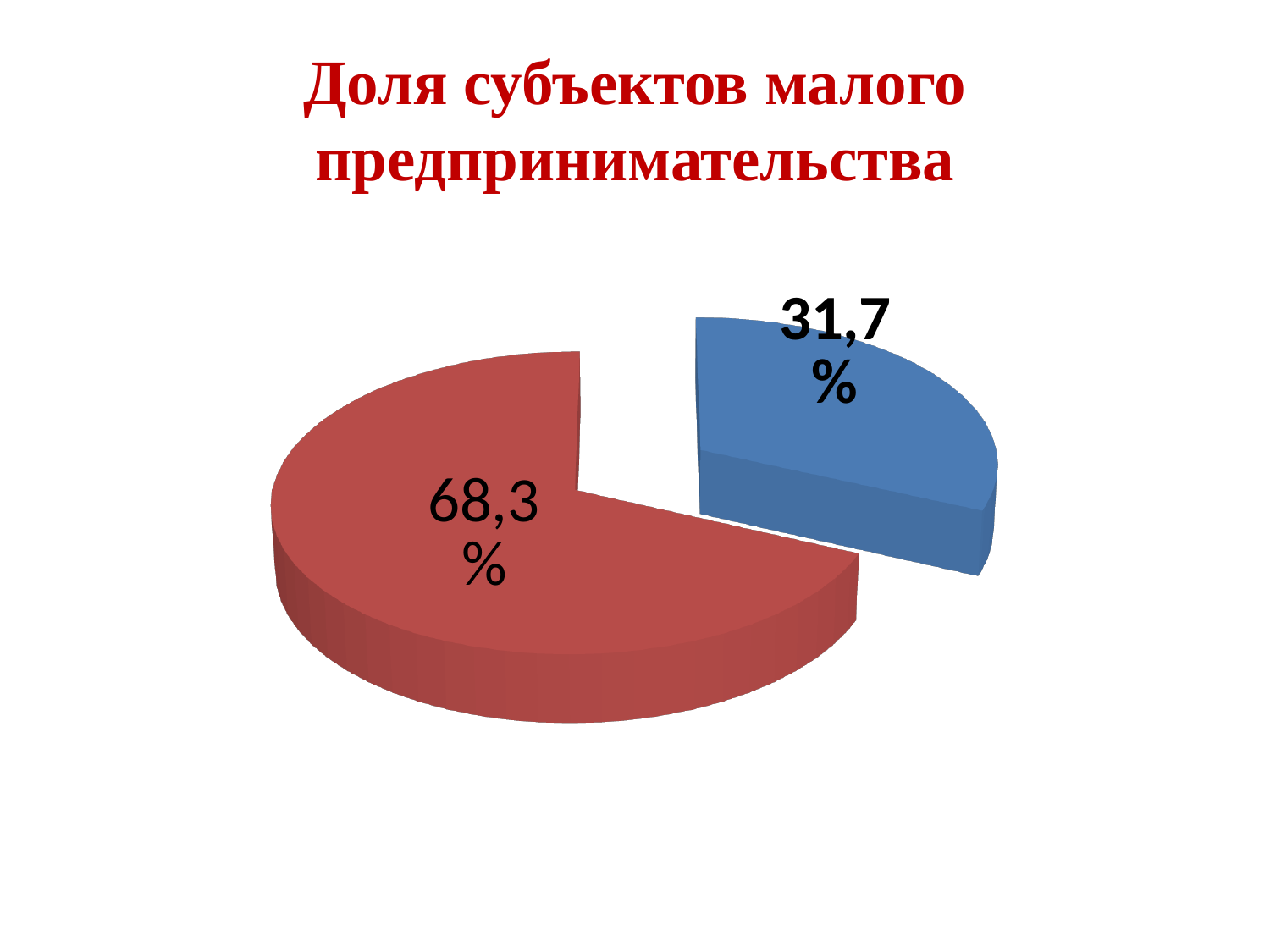
What share of the pie does the blue slice represent? 31,7% Which slice is pulled out (exploded) from the pie? the blue slice What kind of chart is shown on the slide? pie chart What do the two slice values add up to? 100% Which is larger, the red slice or the blue slice? the red slice What is the title of the chart? Доля субъектов малого предпринимательства What value is shown on the blue slice of the pie chart? 31,7% How many slices does the pie chart have? 2 What value is shown on the red slice of the pie chart? 68,3% Which slice of the pie chart is the smallest? the blue slice (31,7%) Which slice of the pie chart is the largest? the red slice (68,3%) What is the difference between the red slice value and the blue slice value? 36,6%